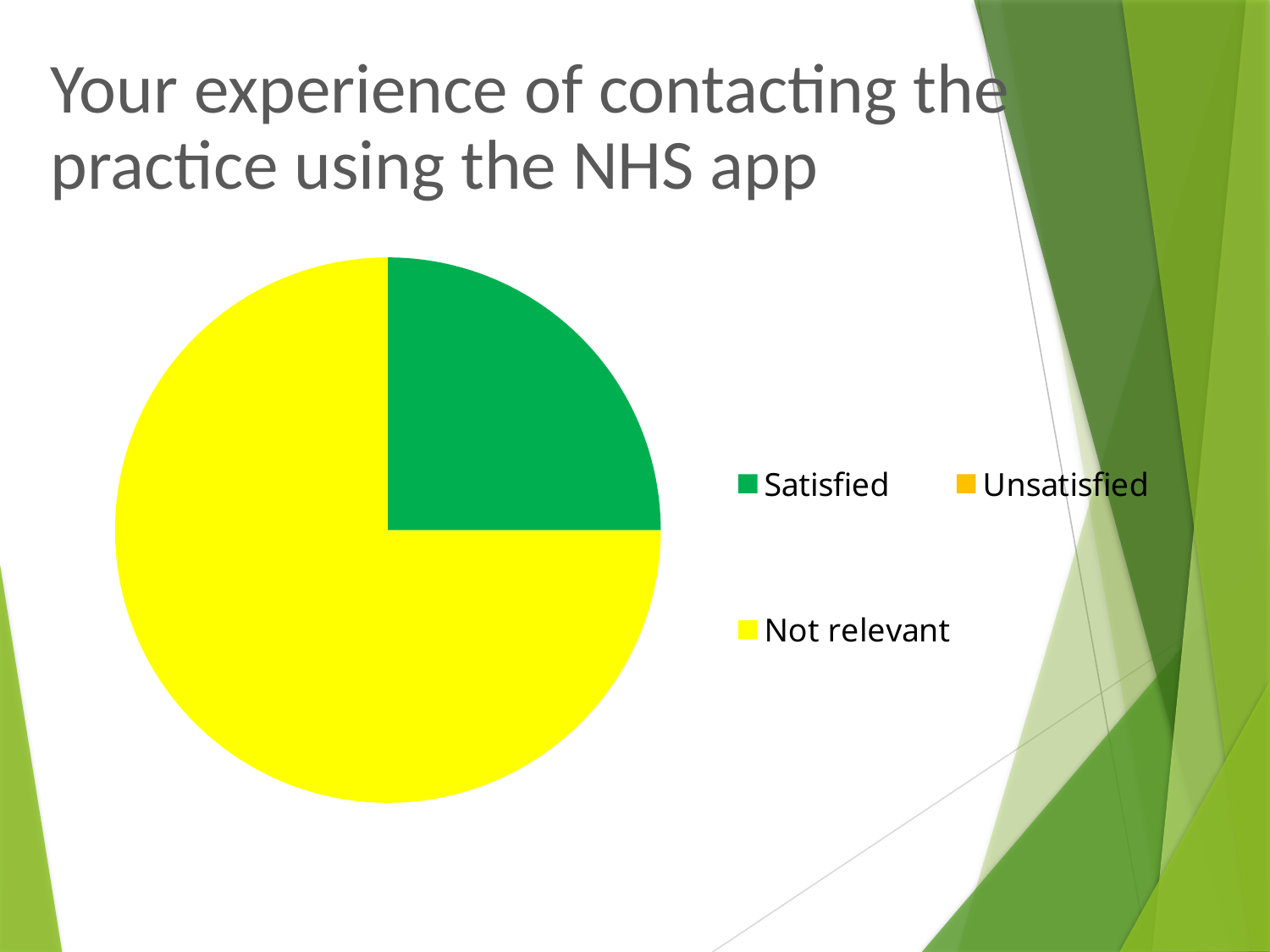
Which is larger in the pie chart, the share for Satisfied or the share for Unsatisfied? Satisfied Which category takes up the largest share of the pie chart? Not relevant What colour represents the Satisfied category in the pie chart? green What colour represents the Not relevant category in the pie chart? yellow How many categories does the legend of the pie chart list? 3 Which category has the smallest share of the pie chart? Unsatisfied Which is larger in the pie chart, the share for Satisfied or the share for Not relevant? Not relevant What kind of chart is shown on the slide? pie chart